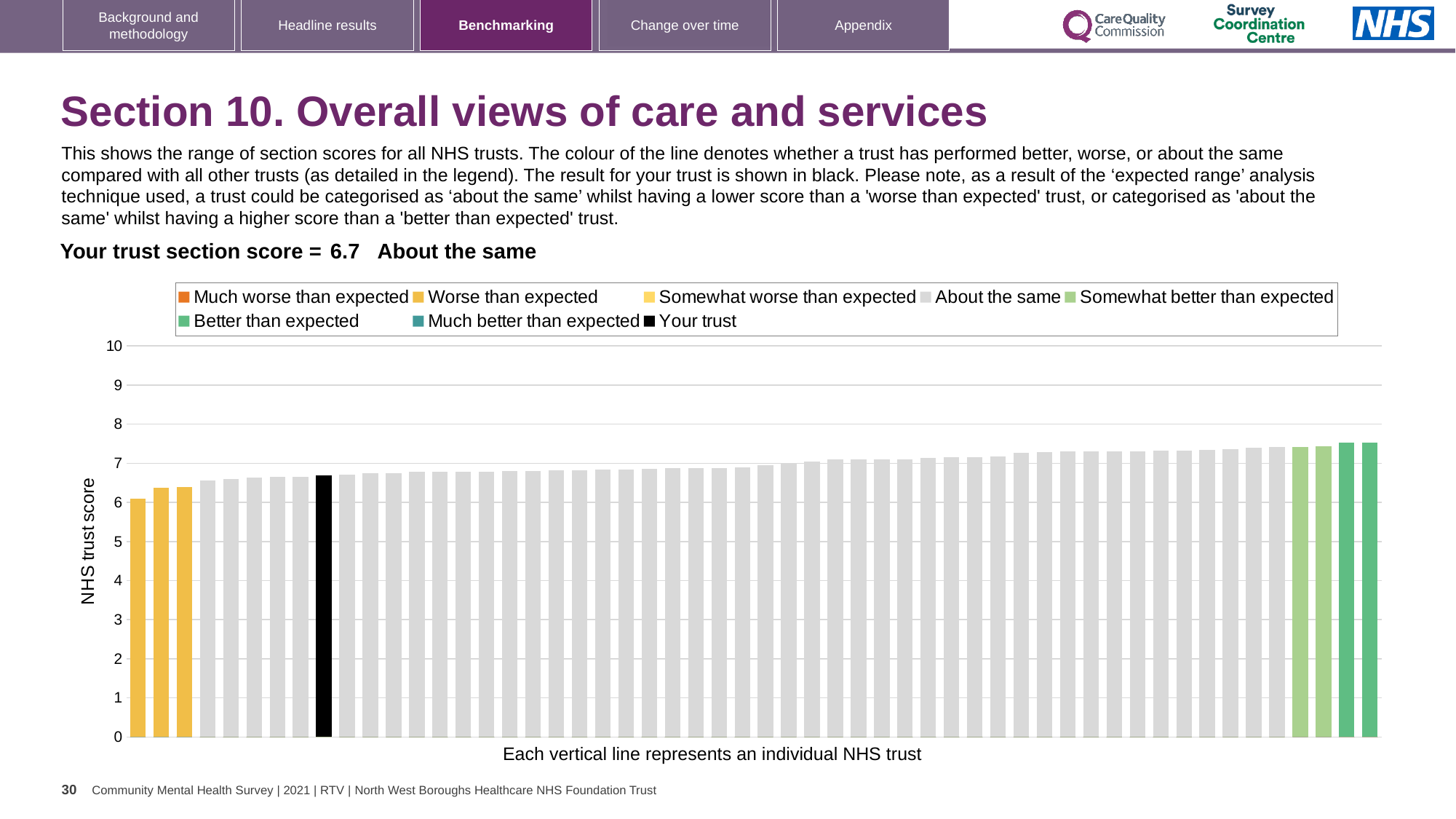
What kind of chart is shown on the slide? bar chart What is the section score for your trust shown on the slide? 6.7 Is the value of the tallest bar on the chart greater or less than 7? greater Is the black 'Your trust' bar higher or lower than the leftmost bar on the chart? higher Is the value of the black 'Your trust' bar greater or less than 7? less How many bars are coloured as 'Better than expected' (dark green)? 2 Is the value of the black 'Your trust' bar greater or less than 6? greater How many entries does the chart legend list? 8 What is the label on the vertical axis of the chart? NHS trust score Do the bar values rise or fall from left to right along the x axis? rise How many bars are coloured as 'Worse than expected' (yellow)? 3 Which performance category is your trust placed in for this section? About the same